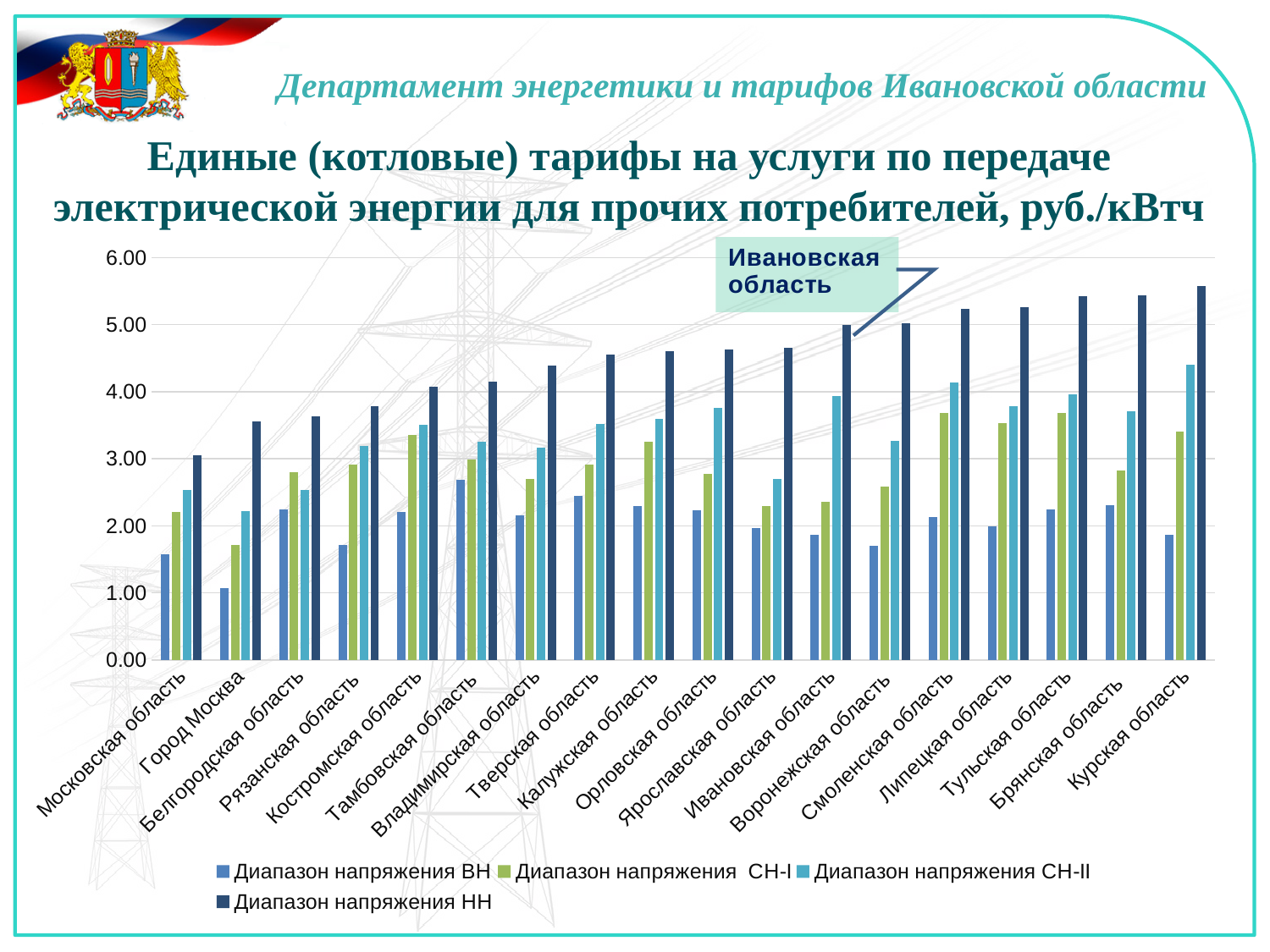
Which region has the lowest value for Диапазон напряжения НН? Московская область Which region has the lowest value for Диапазон напряжения ВН? Город Москва How many regions (categories) are shown on the x axis of the chart? 18 Which region has the highest value for Диапазон напряжения НН? Курская область Which region is highlighted with a callout label on the chart? Ивановская область Is the value for Диапазон напряжения НН for Город Москва greater or less than 3.00? greater Which is larger: the Диапазон напряжения НН value for Ивановская область or for Московская область? Ивановская область What kind of chart is shown on the slide? bar chart Do the values for Диапазон напряжения НН rise or fall from left to right along the x axis? rise Is the value for Диапазон напряжения НН for Курская область greater or less than 5.00? greater Is the value for Диапазон напряжения ВН for Ивановская область greater or less than 2.00? less How many series does the chart legend list? 4